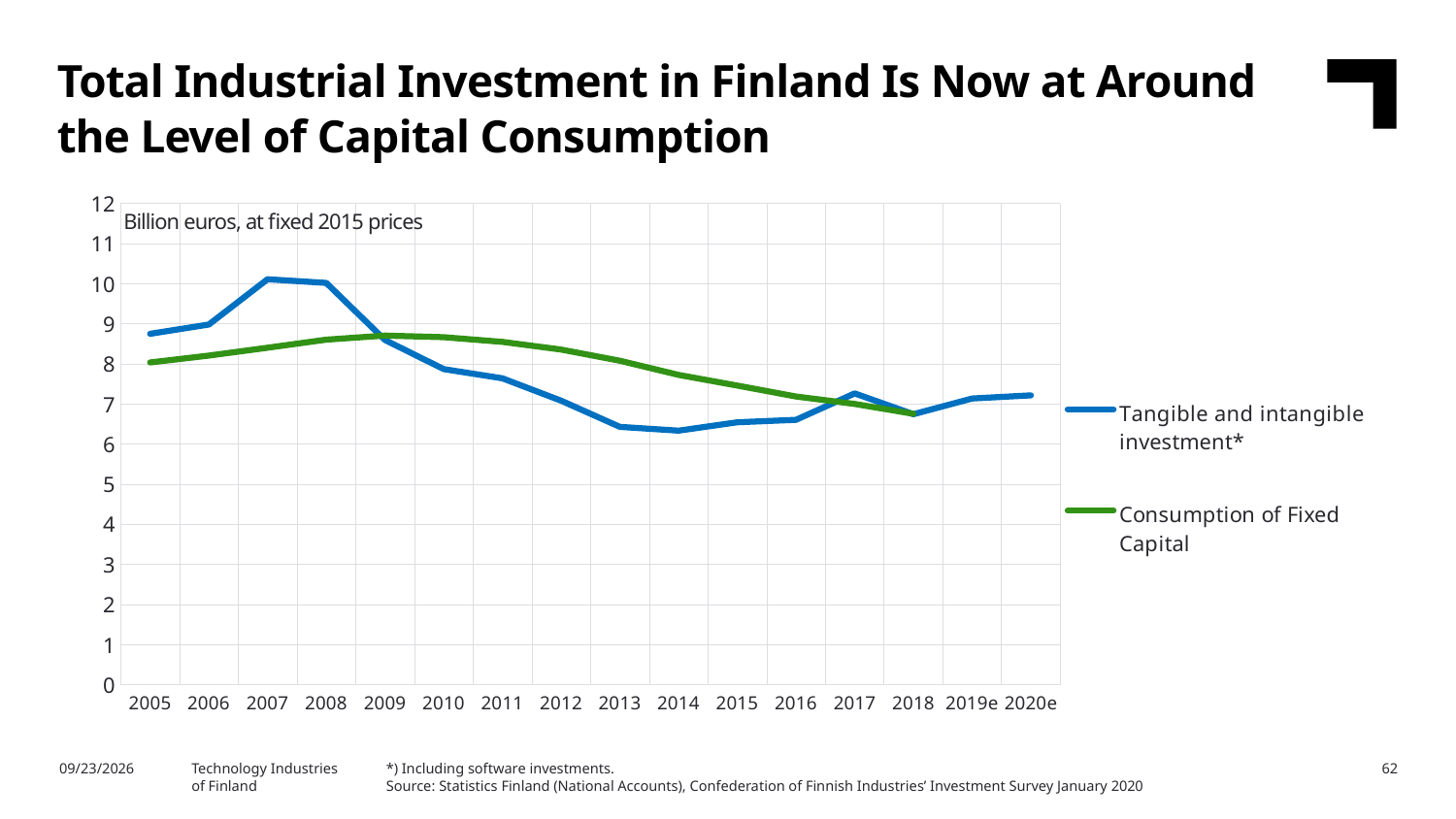
Which series is drawn in green? Consumption of Fixed Capital Is the value for Tangible and intangible investment* in 2014 greater or less than 7? less Is the value for Consumption of Fixed Capital in 2018 greater or less than 7? less Does the Consumption of Fixed Capital line rise or fall between 2010 and 2018? Fall What unit is stated for the values in the chart? Billion euros, at fixed 2015 prices Is the value for Tangible and intangible investment* in 2007 greater or less than 9? greater In 2012, which series has the higher value, Tangible and intangible investment* or Consumption of Fixed Capital? Consumption of Fixed Capital How many years are shown along the x axis? 16 How many series does the legend list? 2 What kind of chart is shown on the slide? Line chart In 2005, which series has the higher value, Tangible and intangible investment* or Consumption of Fixed Capital? Tangible and intangible investment*